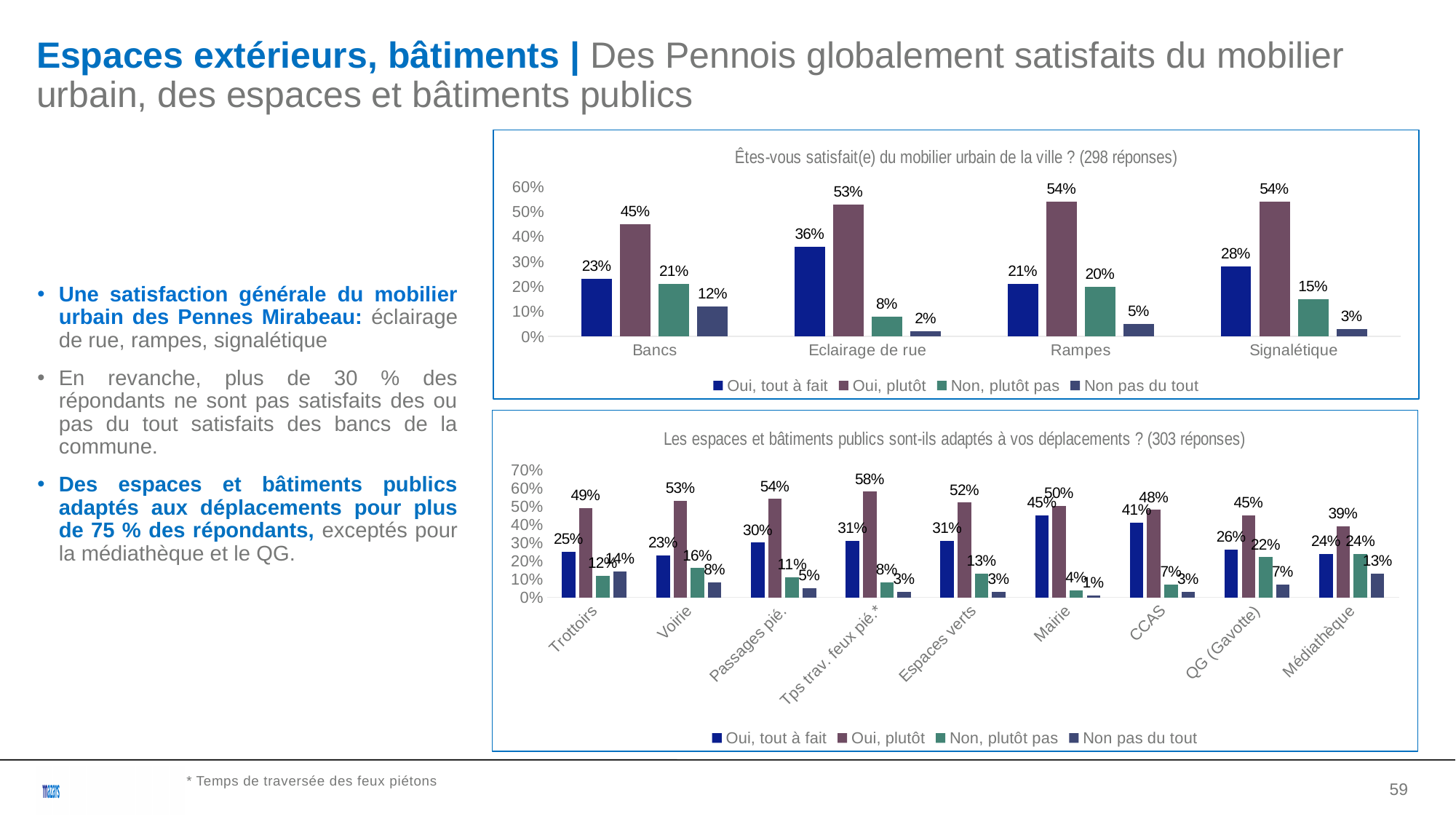
In the top chart (Êtes-vous satisfait(e) du mobilier urbain de la ville ?), how many series does the legend list? 4 In the bottom chart (Les espaces et bâtiments publics sont-ils adaptés à vos déplacements ?), which category has the lowest "Non pas du tout" value? Mairie How many responses does the title of the top chart say were collected? 298 réponses In the top chart (Êtes-vous satisfait(e) du mobilier urbain de la ville ?), what is the value of "Oui, plutôt" for Bancs? 45% What kind of chart is the bottom chart (Les espaces et bâtiments publics sont-ils adaptés à vos déplacements ?)? Bar chart In the top chart (Êtes-vous satisfait(e) du mobilier urbain de la ville ?), which category has the highest "Oui, tout à fait" value? Eclairage de rue In the bottom chart (Les espaces et bâtiments publics sont-ils adaptés à vos déplacements ?), which is larger: the "Oui, tout à fait" value for Mairie or for CCAS? Mairie In the top chart (Êtes-vous satisfait(e) du mobilier urbain de la ville ?), what is the value of "Non pas du tout" for Eclairage de rue? 2% In the bottom chart (Les espaces et bâtiments publics sont-ils adaptés à vos déplacements ?), what is the value of "Oui, plutôt" for Tps trav. feux pié.*? 58% In the top chart (Êtes-vous satisfait(e) du mobilier urbain de la ville ?), what is the difference between the "Non, plutôt pas" values for Bancs and Signalétique? 6% In the top chart (Êtes-vous satisfait(e) du mobilier urbain de la ville ?), how many categories are shown on the x axis? 4 In the bottom chart (Les espaces et bâtiments publics sont-ils adaptés à vos déplacements ?), how many categories are shown on the x axis? 9